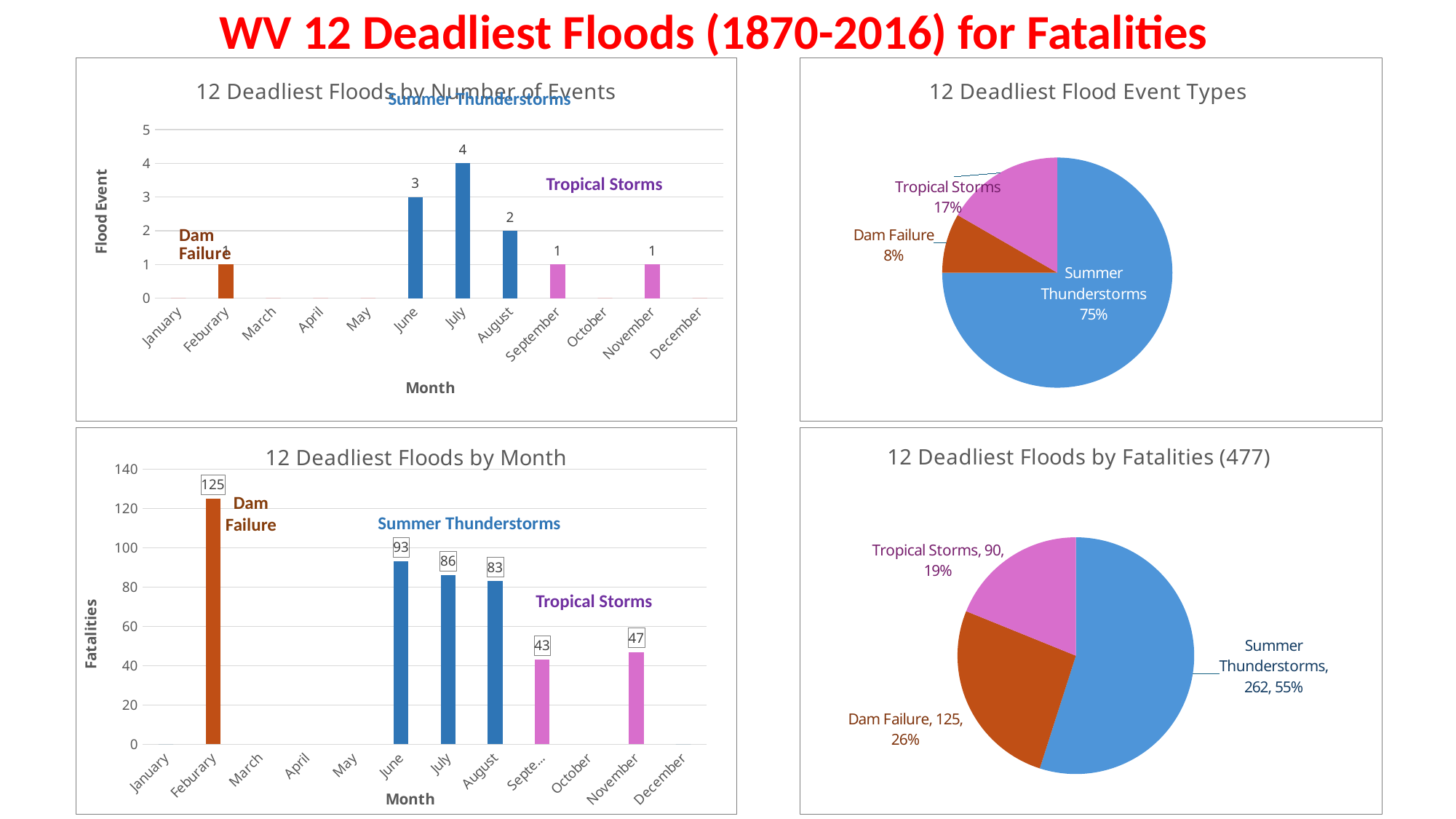
In the '12 Deadliest Floods by Number of Events' chart, which month has the highest number of flood events? July In the '12 Deadliest Floods by Number of Events' chart, what is the difference between the values for June and August? 1 In the '12 Deadliest Floods by Fatalities (477)' pie chart, what is the value for Tropical Storms? 90 In the '12 Deadliest Floods by Month' chart, what is the difference between the values for November and September? 4 In the '12 Deadliest Floods by Month' chart, which month has the highest number of fatalities? February In the '12 Deadliest Floods by Month' chart, what is the value for February? 125 What kind of chart is '12 Deadliest Floods by Fatalities (477)'? pie chart In the '12 Deadliest Floods by Month' chart, is the value for August greater or less than 100? less In the '12 Deadliest Floods by Number of Events' chart, what is the value for July? 4 In the '12 Deadliest Flood Event Types' pie chart, which event type has the smallest slice? Dam Failure In the '12 Deadliest Floods by Month' chart, which is larger, the value for June or the value for July? June In the '12 Deadliest Flood Event Types' pie chart, what share does Summer Thunderstorms have? 75%